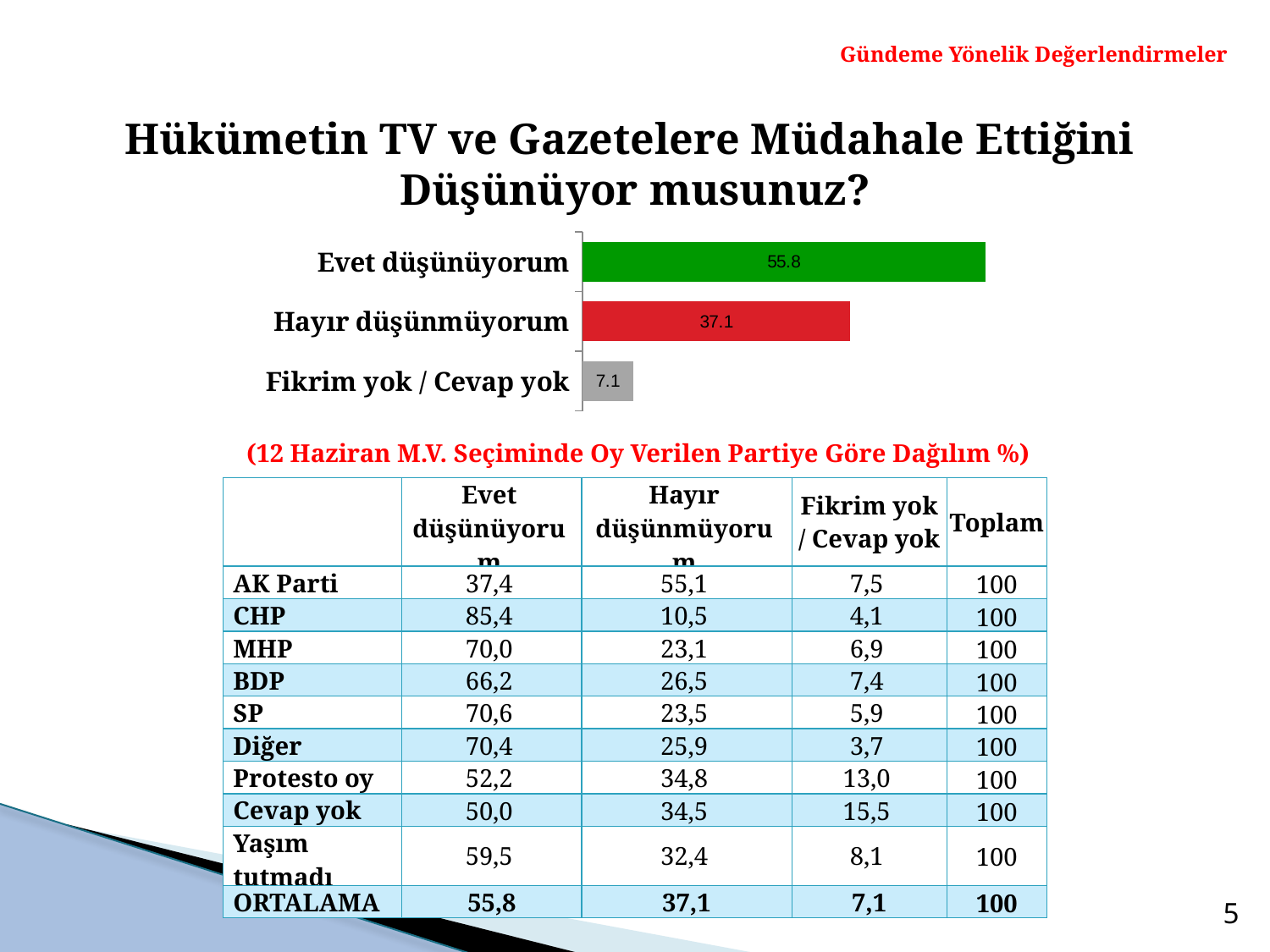
What type of chart is shown on the slide? Bar chart What value is shown for "Fikrim yok / Cevap yok" in the bar chart? 7.1 What is the difference between the values for "Evet düşünüyorum" and "Hayır düşünmüyorum" in the bar chart? 18.7 How many categories are shown in the bar chart? 3 What colour is the bar for "Hayır düşünmüyorum" in the chart? Red What is the difference between the values for "Hayır düşünmüyorum" and "Fikrim yok / Cevap yok" in the bar chart? 30.0 Which category has the highest value in the bar chart? Evet düşünüyorum What value is shown for "Evet düşünüyorum" in the bar chart? 55.8 Which is larger in the bar chart: the value for "Hayır düşünmüyorum" or the value for "Fikrim yok / Cevap yok"? Hayır düşünmüyorum What value is shown for "Hayır düşünmüyorum" in the bar chart? 37.1 Which category has the lowest value in the bar chart? Fikrim yok / Cevap yok What colour is the bar for "Evet düşünüyorum" in the chart? Green